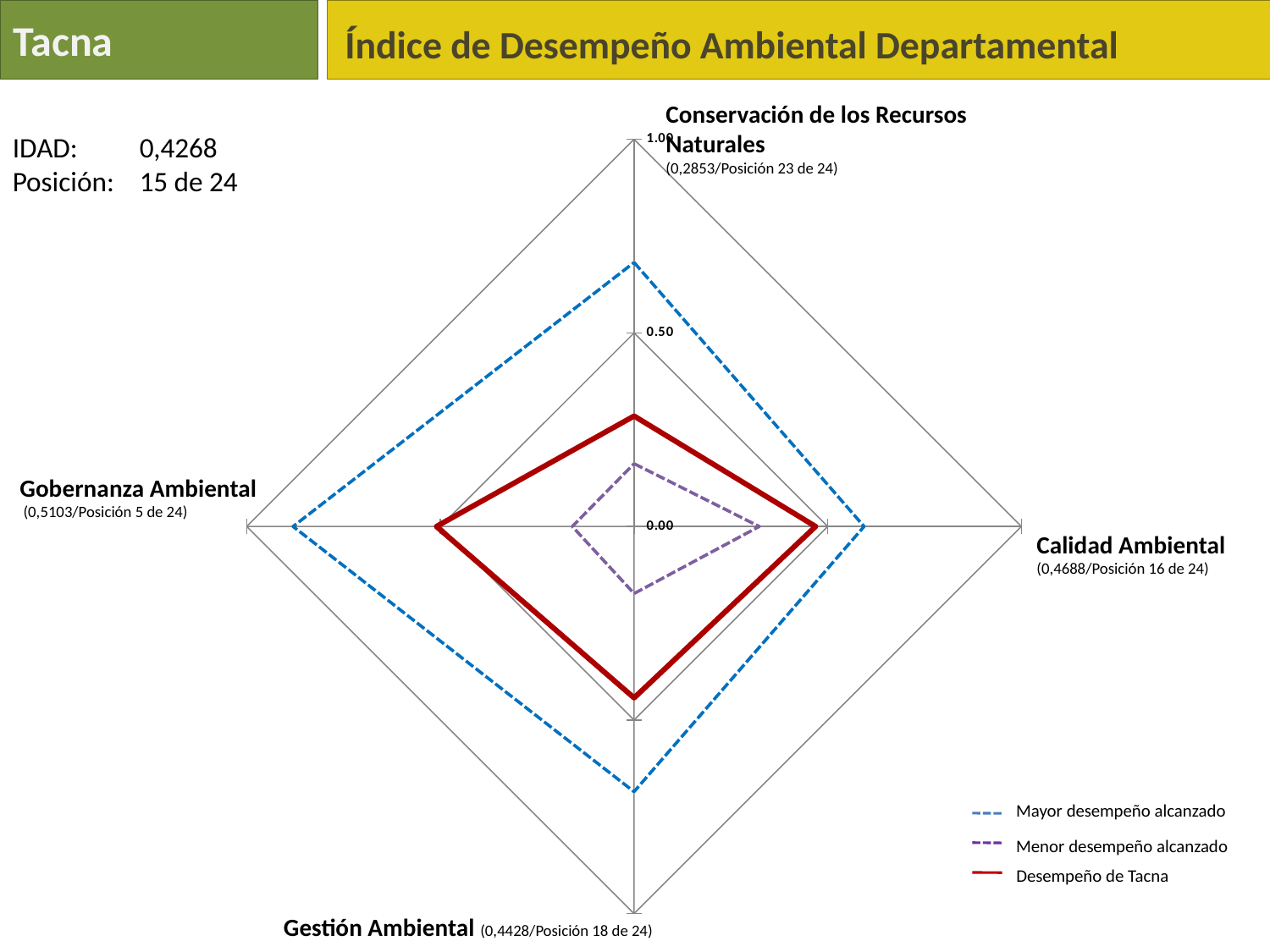
What is Tacna's value for Gestión Ambiental? 0,4428 Is the 'Mayor desempeño alcanzado' value for Gobernanza Ambiental greater or less than 0.50? greater How many axes (categories) does the radar chart have? 4 What is Tacna's value for Calidad Ambiental? 0,4688 In which category does Tacna have its lowest value? Conservación de los Recursos Naturales How many series does the chart legend list? 3 Which series is drawn with the solid red line? Desempeño de Tacna In which category does Tacna have its highest value? Gobernanza Ambiental What is Tacna's value for Conservación de los Recursos Naturales? 0,2853 What is the difference between Tacna's values for Gobernanza Ambiental and Conservación de los Recursos Naturales? 0,2250 What is Tacna's value for Gobernanza Ambiental? 0,5103 What type of chart is shown on the slide? Radar chart